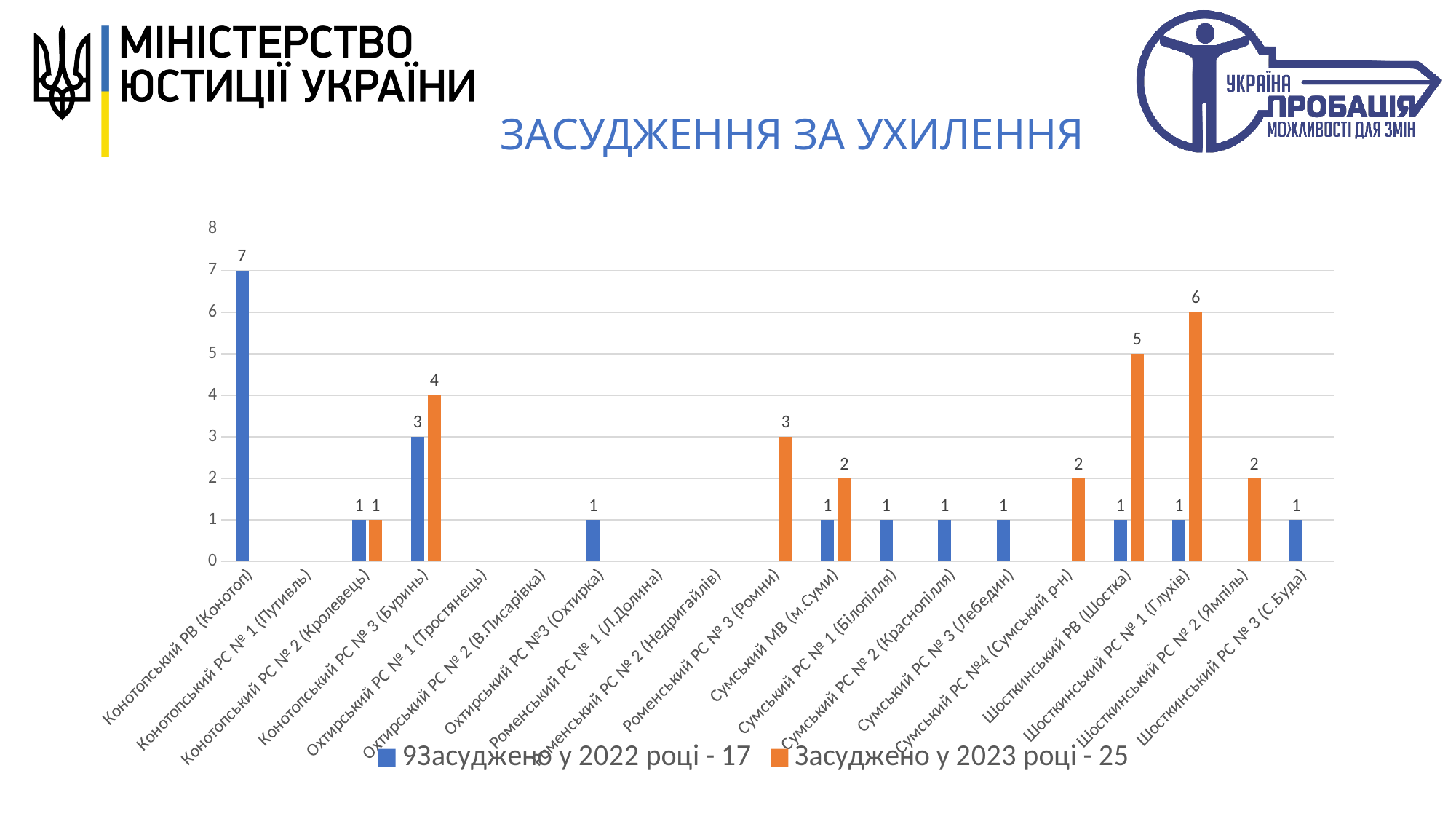
Which category has the highest value in the 2023 series? Шосткинський РС № 1 (Глухів) Which is larger for Сумський МВ (м.Суми): the 2022 value or the 2023 value? 2023 What is the value for Роменський РС № 3 (Ромни) in the 2023 series? 3 What is the title of the chart? ЗАСУДЖЕННЯ ЗА УХИЛЕННЯ What is the difference between the 2022 values for Конотопський РВ (Конотоп) and Конотопський РС № 3 (Буринь)? 4 What is the value for Конотопський РС № 3 (Буринь) in the 2023 series? 4 What is the difference between the 2023 and 2022 values for Шосткинський РВ (Шостка)? 4 What is the value for Конотопський РВ (Конотоп) in the 2022 series? 7 What is the value for Шосткинський РС № 1 (Глухів) in the 2023 series? 6 How many series does the legend list? 2 What type of chart is shown on the slide? bar chart Which category has the highest value in the 2022 series? Конотопський РВ (Конотоп)